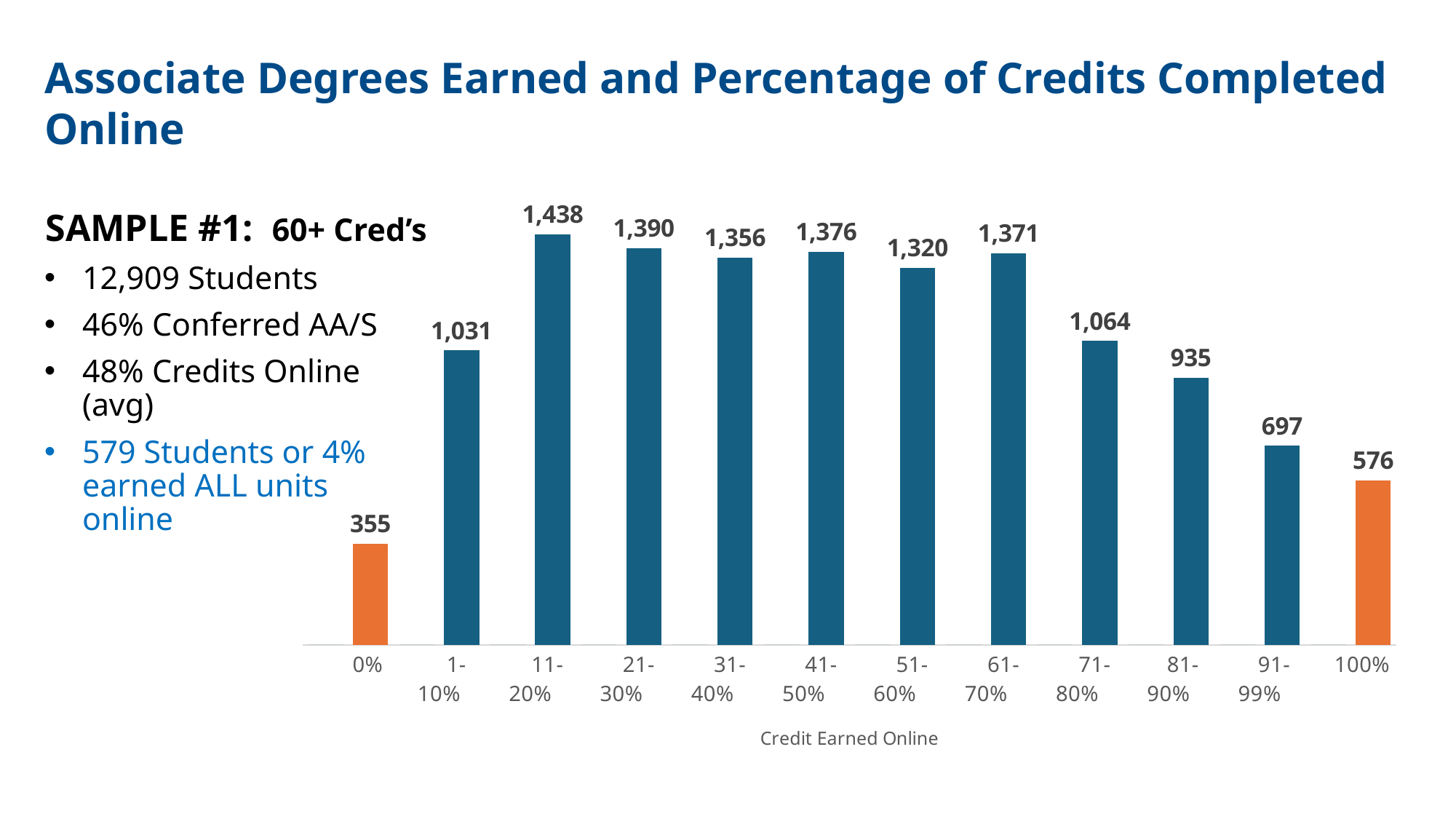
Which category has the lowest value? 0% Which is larger, the value for 81-90% or the value for 91-99%? 81-90% What is the x-axis title of the chart? Credit Earned Online What is the value for the 100% category? 576 What is the value for the 11-20% category? 1,438 What is the value for the 0% category? 355 What is the value for the 71-80% category? 1,064 What kind of chart is shown on the slide? bar chart How many categories are shown on the x axis? 12 What is the difference between the values for 100% and 0%? 221 What is the difference between the values for 11-20% and 1-10%? 407 Which category has the highest value? 11-20%